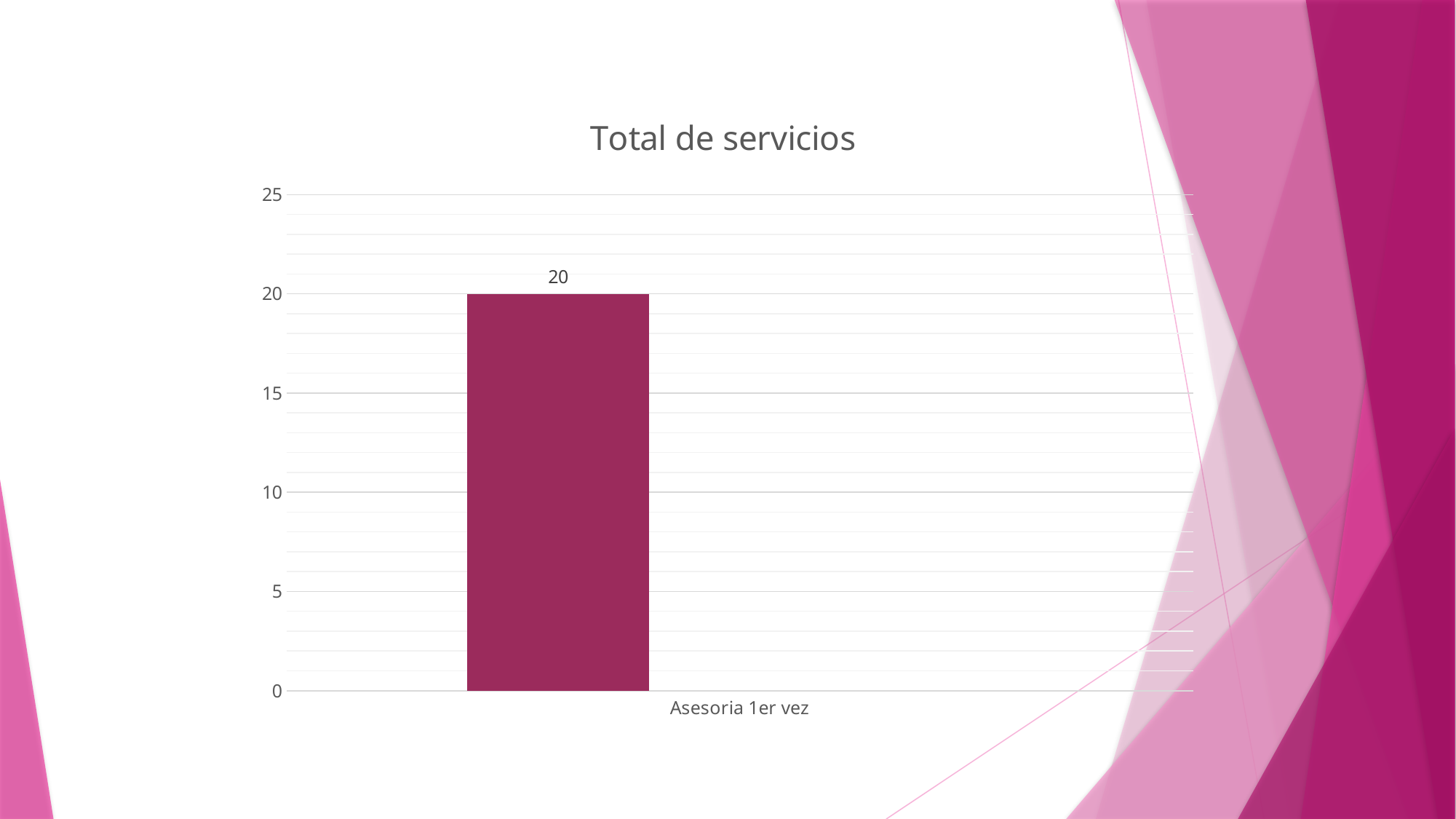
What is the value for Asesoria 1er vez? 20 What is the label of the only category on the x axis? Asesoria 1er vez What is the maximum value shown on the vertical axis? 25 Is the value for Asesoria 1er vez greater or less than 15? greater How many categories are plotted in the chart? 1 What is the title of the chart? Total de servicios Is the value for Asesoria 1er vez greater or less than 25? less What kind of chart is shown on the slide? bar chart